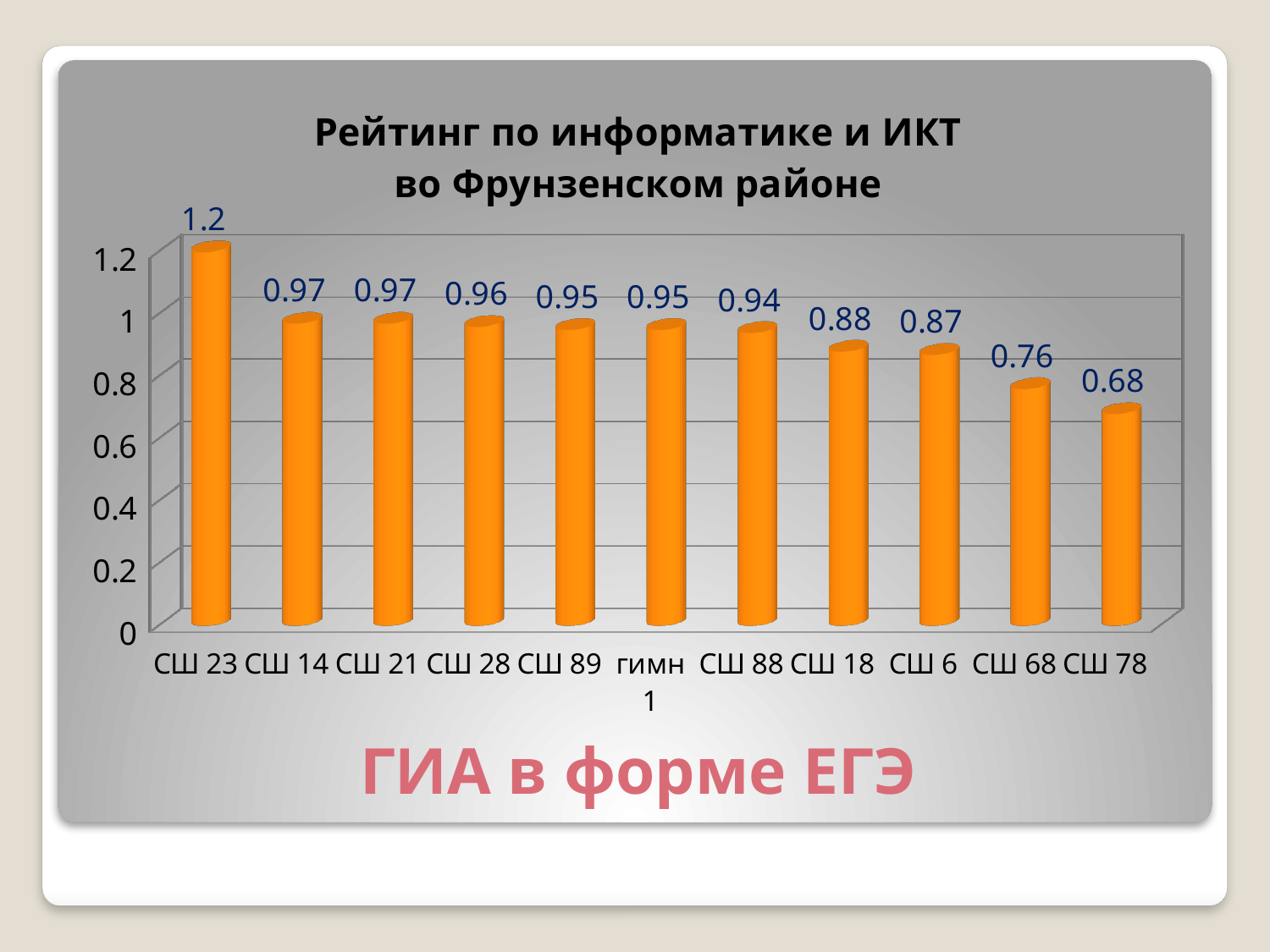
What is the difference between the values for СШ 23 and СШ 78? 0.52 What kind of chart is this? bar chart Is the value for СШ 6 greater or less than 0.8? greater Do the values rise or fall from left to right along the x axis? fall What is the value for СШ 68? 0.76 What is the value for гимн 1? 0.95 What is the value for СШ 23? 1.2 What is the difference between the values for СШ 18 and СШ 6? 0.01 Which category has the lowest value? СШ 78 How many categories are shown on the x axis? 11 Which category has the highest value? СШ 23 Which is larger, the value for СШ 88 or the value for СШ 68? СШ 88